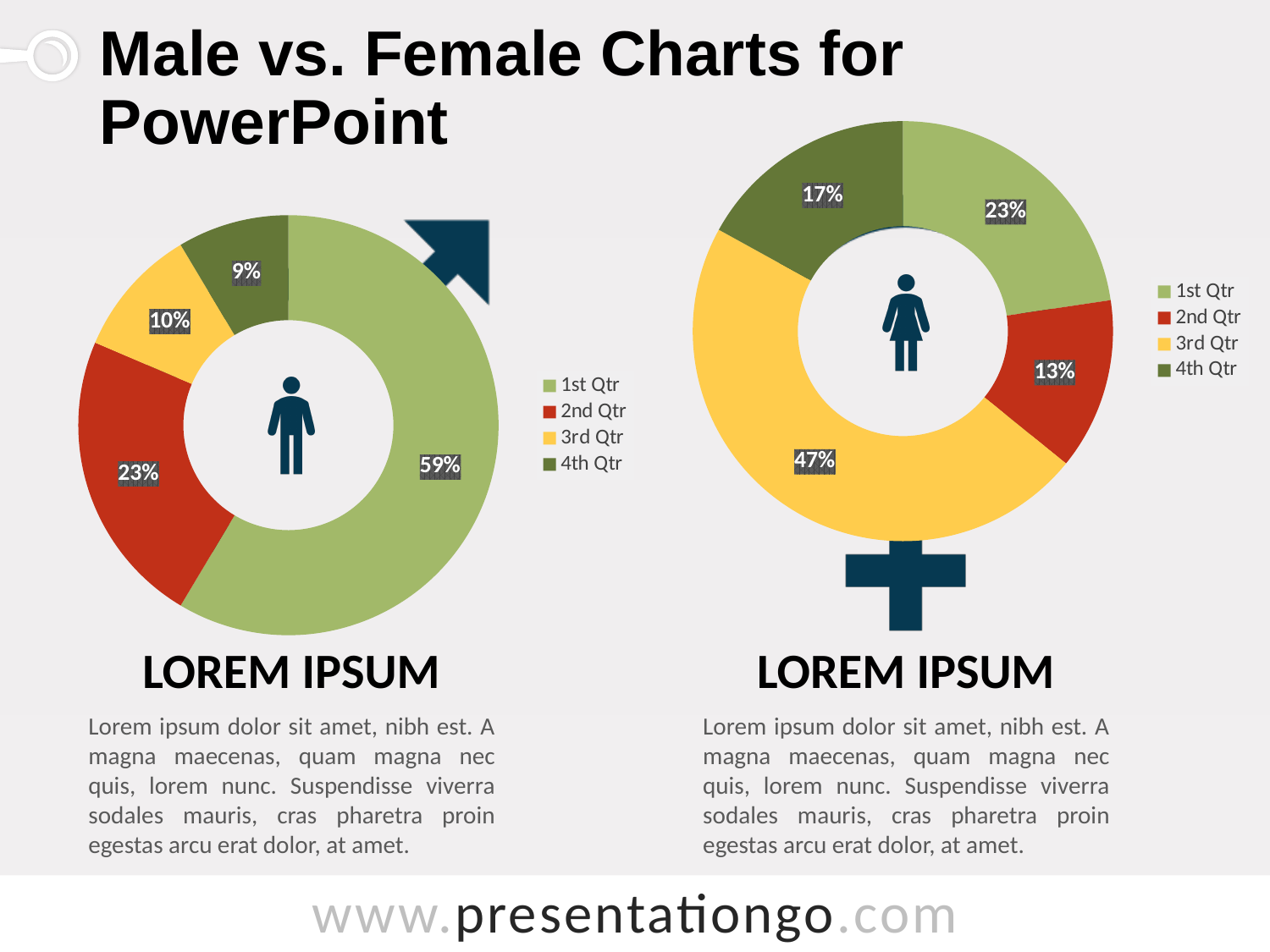
In the right (female) doughnut chart, what is the value for 3rd Qtr? 47% In the left (male) doughnut chart, which quarter has the largest share? 1st Qtr In the left (male) doughnut chart, what is the value for 1st Qtr? 59% In the right (female) doughnut chart, which quarter has the largest share? 3rd Qtr In the left (male) doughnut chart, which quarter has the smallest share? 4th Qtr In the right (female) doughnut chart, what is the value for 2nd Qtr? 13% In the left (male) doughnut chart, what is the value for 3rd Qtr? 10% In the left (male) doughnut chart, what is the difference between the 1st Qtr and 2nd Qtr values? 36% In the right (female) doughnut chart, which quarter has the smallest share? 2nd Qtr What type of chart is the left (male) chart? Doughnut chart In the right (female) doughnut chart, which is larger, 1st Qtr or 4th Qtr? 1st Qtr How many series does the legend of the right (female) doughnut chart list? 4